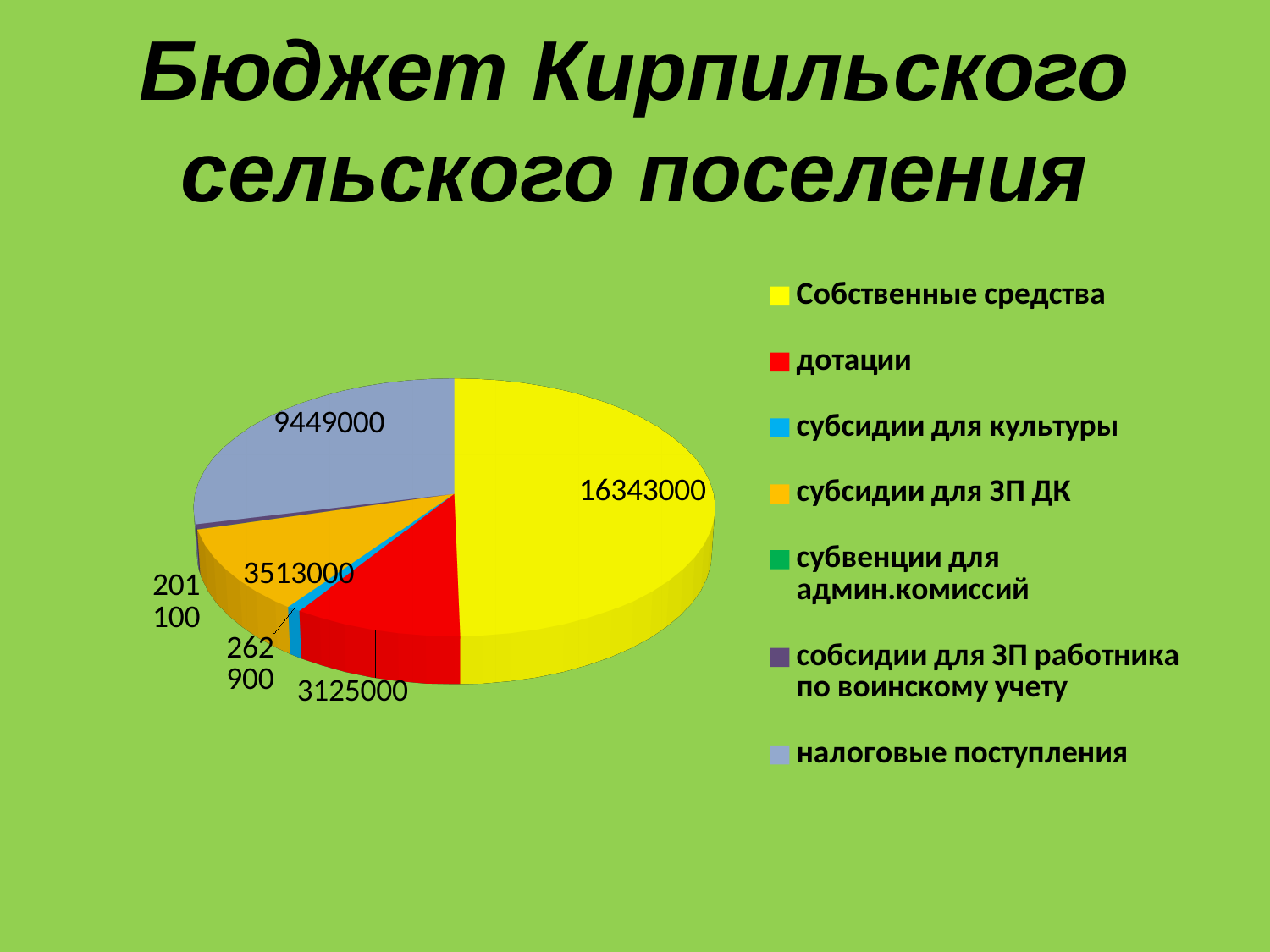
What is the title of the slide? Бюджет Кирпильского сельского поселения Which category has the largest slice of the pie chart? Собственные средства What is the difference between the values for субсидии для ЗП ДК and дотации? 388000 Which is larger: the value for дотации or the value for налоговые поступления? налоговые поступления What value is shown for налоговые поступления on the pie chart? 9449000 How many entries does the legend of the pie chart list? 7 What value is shown for Собственные средства on the pie chart? 16343000 What value is shown for субсидии для культуры on the pie chart? 262900 What kind of chart is shown on the slide? Pie chart What is the difference between the values for Собственные средства and налоговые поступления? 6894000 What value is shown for субсидии для ЗП ДК on the pie chart? 3513000 What value is shown for дотации on the pie chart? 3125000